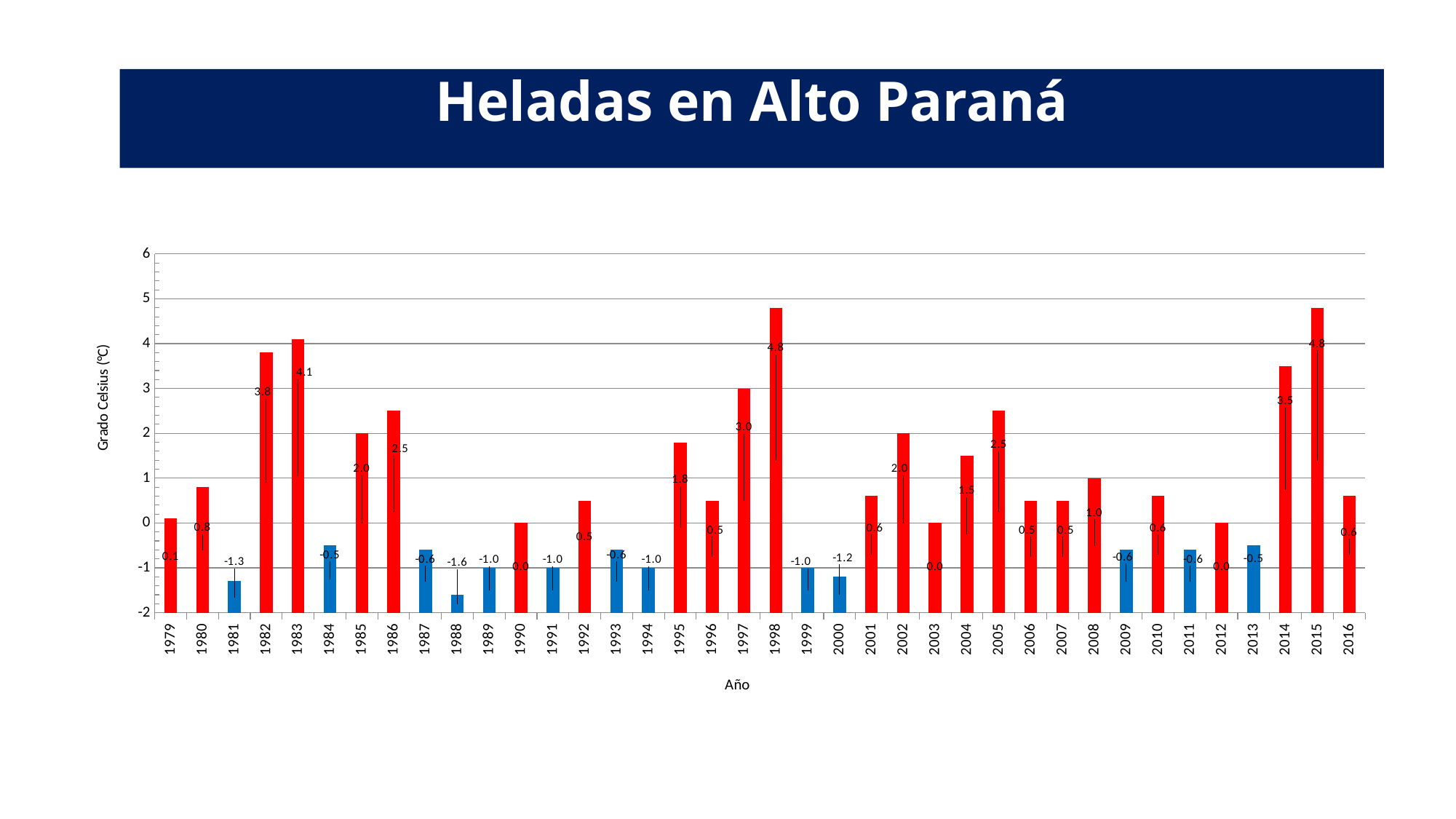
What is the value for 2014? 3.5 What is the value for 1983? 4.1 Which is larger, the value for 1997 or the value for 2014? 2014 What is the value for 1988? -1.6 What is the title of the chart? Heladas en Alto Paraná Which year has the lowest value? 1988 What is the value for 2000? -1.2 What type of chart is shown on the slide? bar chart What is the label of the vertical axis? Grado Celsius (°C) How many years are shown on the x axis? 38 Which two years share the highest value of 4.8? 1998 and 2015 What is the difference between the values for 1983 and 1982? 0.3